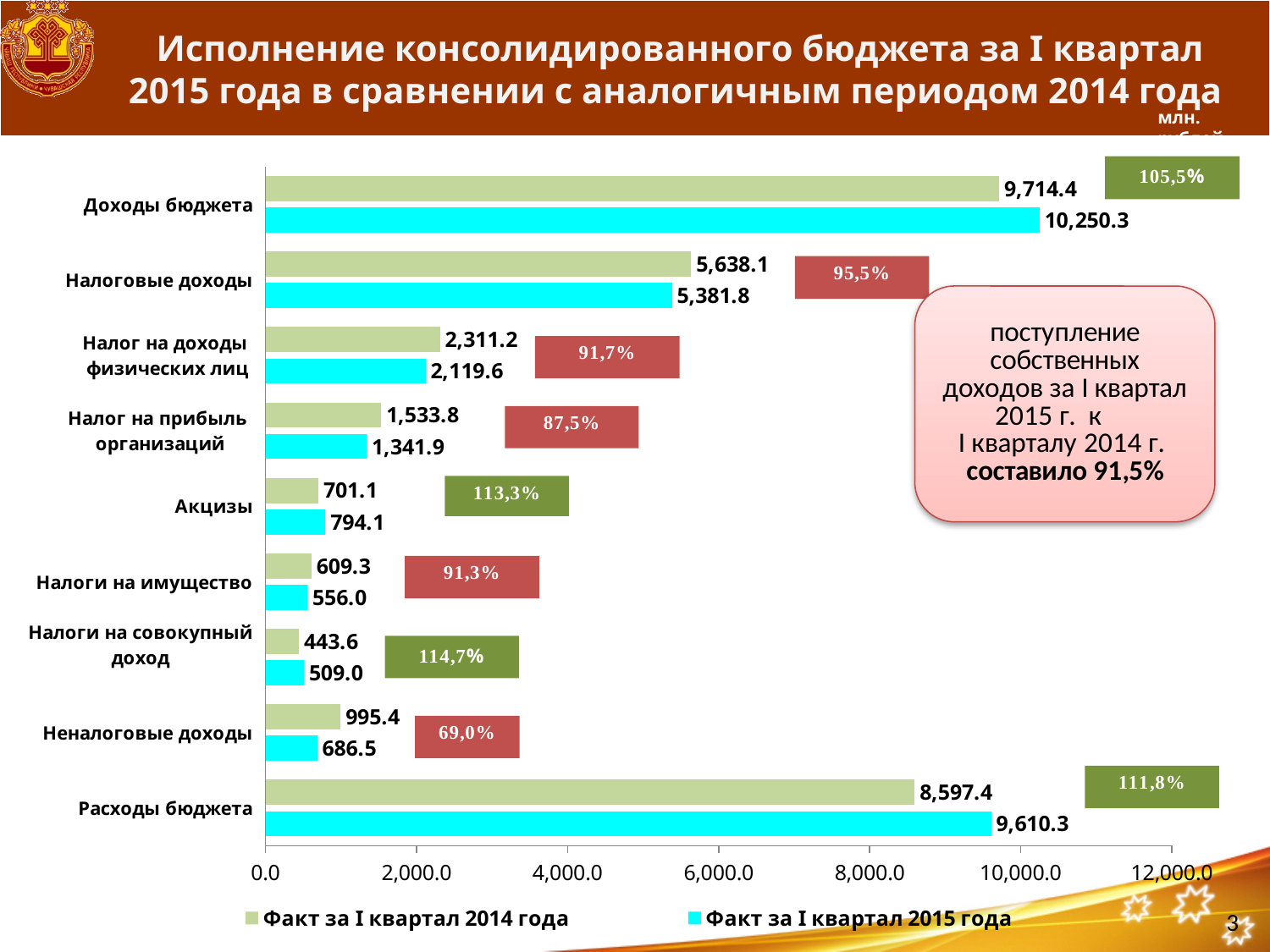
What is the value for Доходы бюджета in the series Факт за I квартал 2015 года? 10,250.3 Which category has the highest value in the series Факт за I квартал 2015 года? Доходы бюджета What kind of chart is shown on the slide? Bar chart What is the value for Акцизы in the series Факт за I квартал 2015 года? 794.1 How many categories are shown on the chart? 9 What is the difference between the 2015 and 2014 values for Расходы бюджета? 1,012.9 How many series does the legend list? 2 What is the value for Неналоговые доходы in the series Факт за I квартал 2014 года? 995.4 For Налог на прибыль организаций, which series has the larger value: Факт за I квартал 2014 года or Факт за I квартал 2015 года? Факт за I квартал 2014 года What percentage is shown in the box next to the Акцизы bars? 113,3% What is the value for Налоговые доходы in the series Факт за I квартал 2014 года? 5,638.1 Which category has the lowest value in the series Факт за I квартал 2014 года? Налоги на совокупный доход